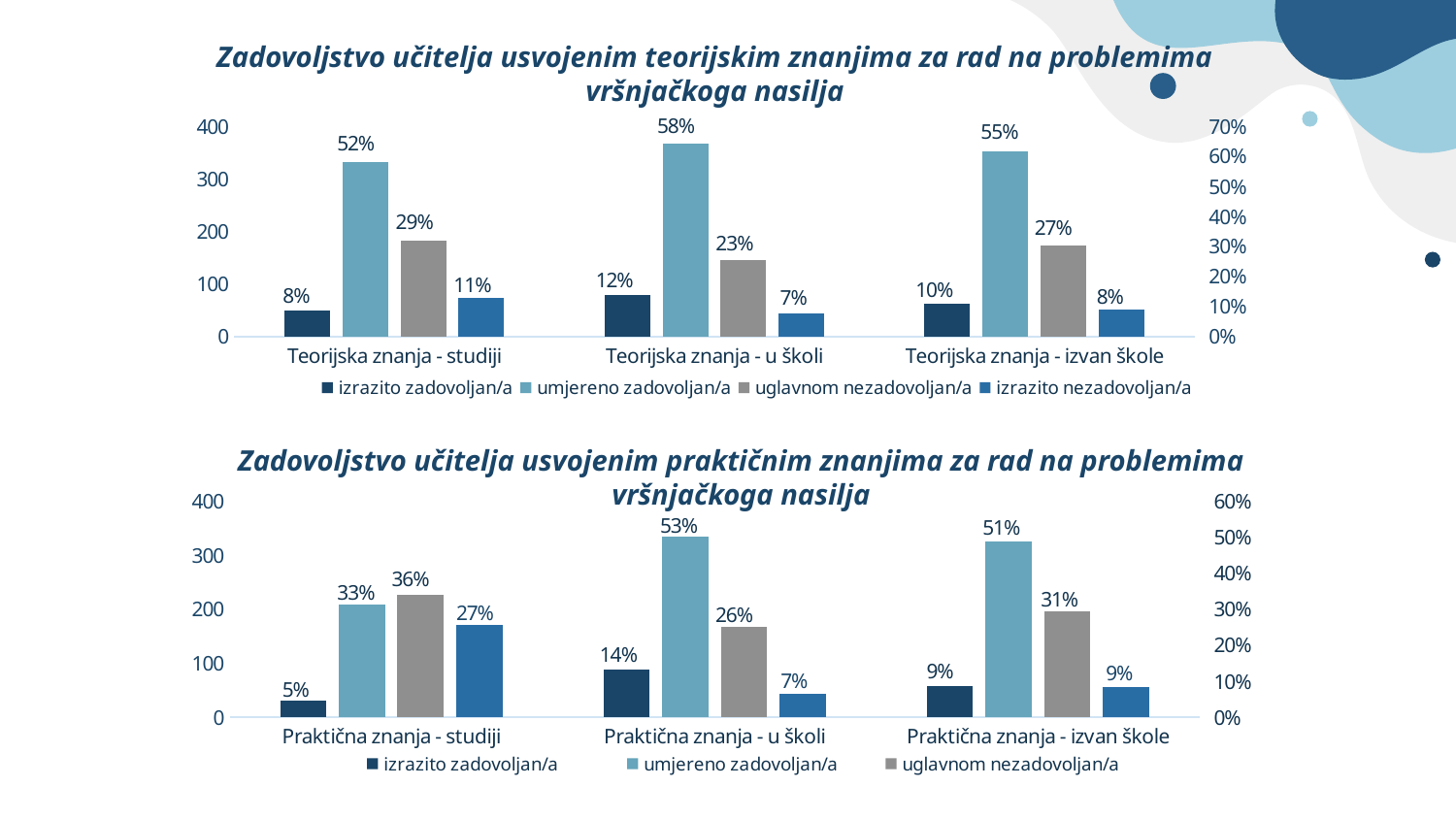
In the bottom chart (praktična znanja), what is the value for 'uglavnom nezadovoljan/a' in the category 'Praktična znanja - studiji'? 36% What kind of chart is the bottom chart (praktična znanja)? bar chart In the top chart (teorijska znanja), what is the difference between 'umjereno zadovoljan/a' and 'uglavnom nezadovoljan/a' in the category 'Teorijska znanja - izvan škole'? 28% In the top chart (teorijska znanja), what is the value for 'umjereno zadovoljan/a' in the category 'Teorijska znanja - u školi'? 58% In the bottom chart (praktična znanja), which category has the lowest value for 'izrazito zadovoljan/a'? Praktična znanja - studiji How many series does the legend of the bottom chart (praktična znanja) list? 3 How many categories are shown on the x axis of the top chart (teorijska znanja)? 3 In the top chart (teorijska znanja), which category has the highest value for 'umjereno zadovoljan/a'? Teorijska znanja - u školi In the bottom chart (praktična znanja), what is the value for 'izrazito zadovoljan/a' in the category 'Praktična znanja - u školi'? 14% In the top chart (teorijska znanja), what is the value for 'izrazito zadovoljan/a' in the category 'Teorijska znanja - studiji'? 8% In the bottom chart (praktična znanja), which is larger in the category 'Praktična znanja - studiji': 'umjereno zadovoljan/a' or 'uglavnom nezadovoljan/a'? uglavnom nezadovoljan/a How many series does the legend of the top chart (teorijska znanja) list? 4